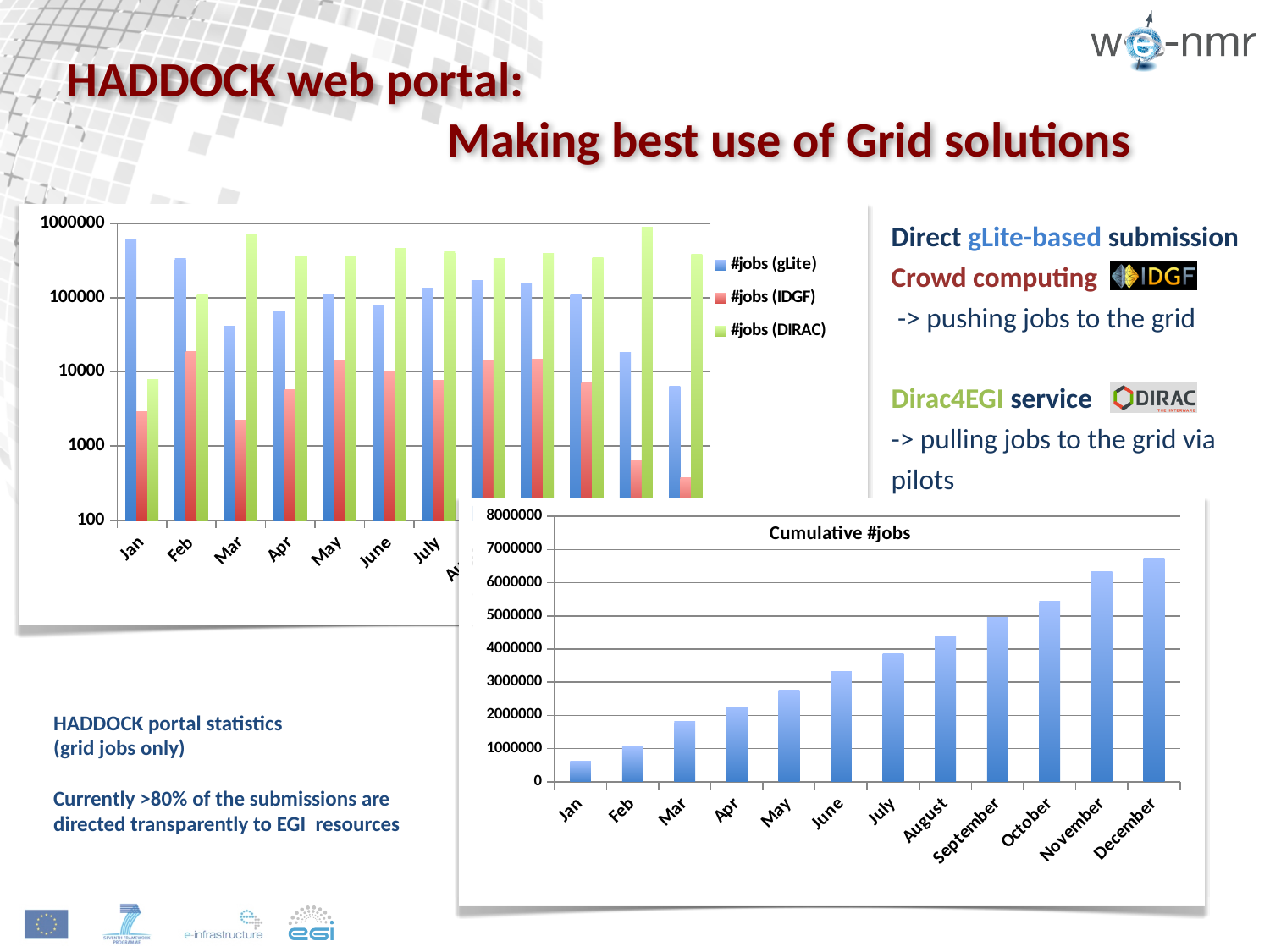
In the 'Cumulative #jobs' chart, which month has the lowest value? Jan In the top-left monthly jobs chart, which series is larger in Mar: #jobs (gLite) or #jobs (DIRAC)? #jobs (DIRAC) In the 'Cumulative #jobs' chart, which month has the highest value? December In the 'Cumulative #jobs' chart, is the value for December greater or less than 6000000? greater In the 'Cumulative #jobs' chart, is the value for Jan greater or less than 1000000? less In the top-left monthly jobs chart, which series is larger in Jan: #jobs (gLite) or #jobs (DIRAC)? #jobs (gLite) What type of chart is the 'Cumulative #jobs' chart? bar chart In the 'Cumulative #jobs' chart, how many months are shown on the x axis? 12 How many series does the legend of the top-left monthly jobs chart list? 3 In the top-left monthly jobs chart, is the value of #jobs (gLite) for Jan greater or less than 100000? greater In the 'Cumulative #jobs' chart, do the values rise or fall from Jan to December? rise